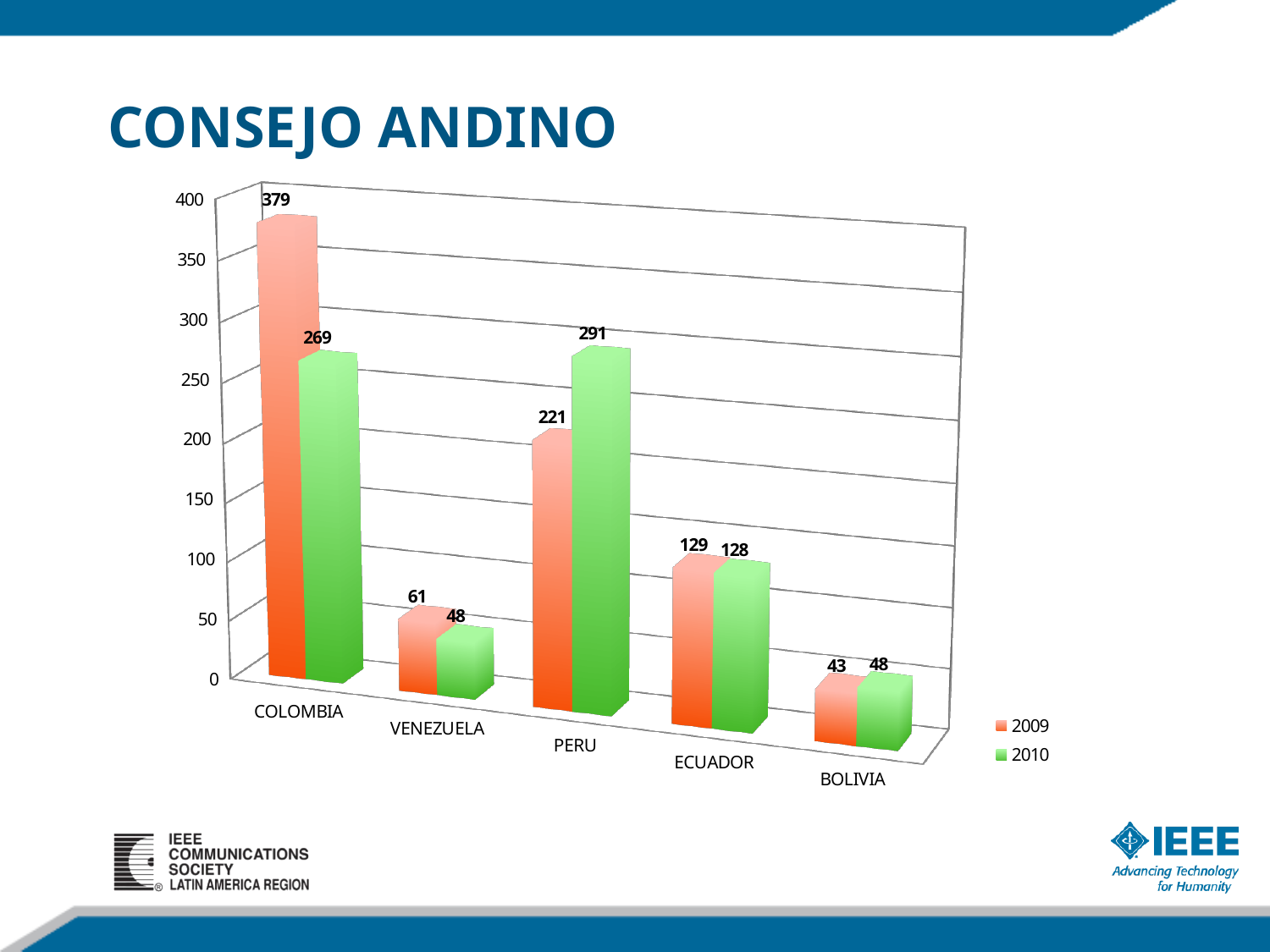
What is the difference between COLOMBIA's 2009 and 2010 values? 110 What is the value for COLOMBIA in 2009? 379 How many countries are shown on the chart? 5 What is the value for PERU in 2010? 291 What is the title of the slide? CONSEJO ANDINO How many series does the legend list? 2 What is the value for VENEZUELA in 2010? 48 Which is larger for PERU, the 2009 value or the 2010 value? 2010 What is the difference between PERU's 2010 and 2009 values? 70 Which country has the highest value in 2009? COLOMBIA Which country has the lowest value in 2010? VENEZUELA and BOLIVIA (both 48) What kind of chart is shown on the slide? bar chart